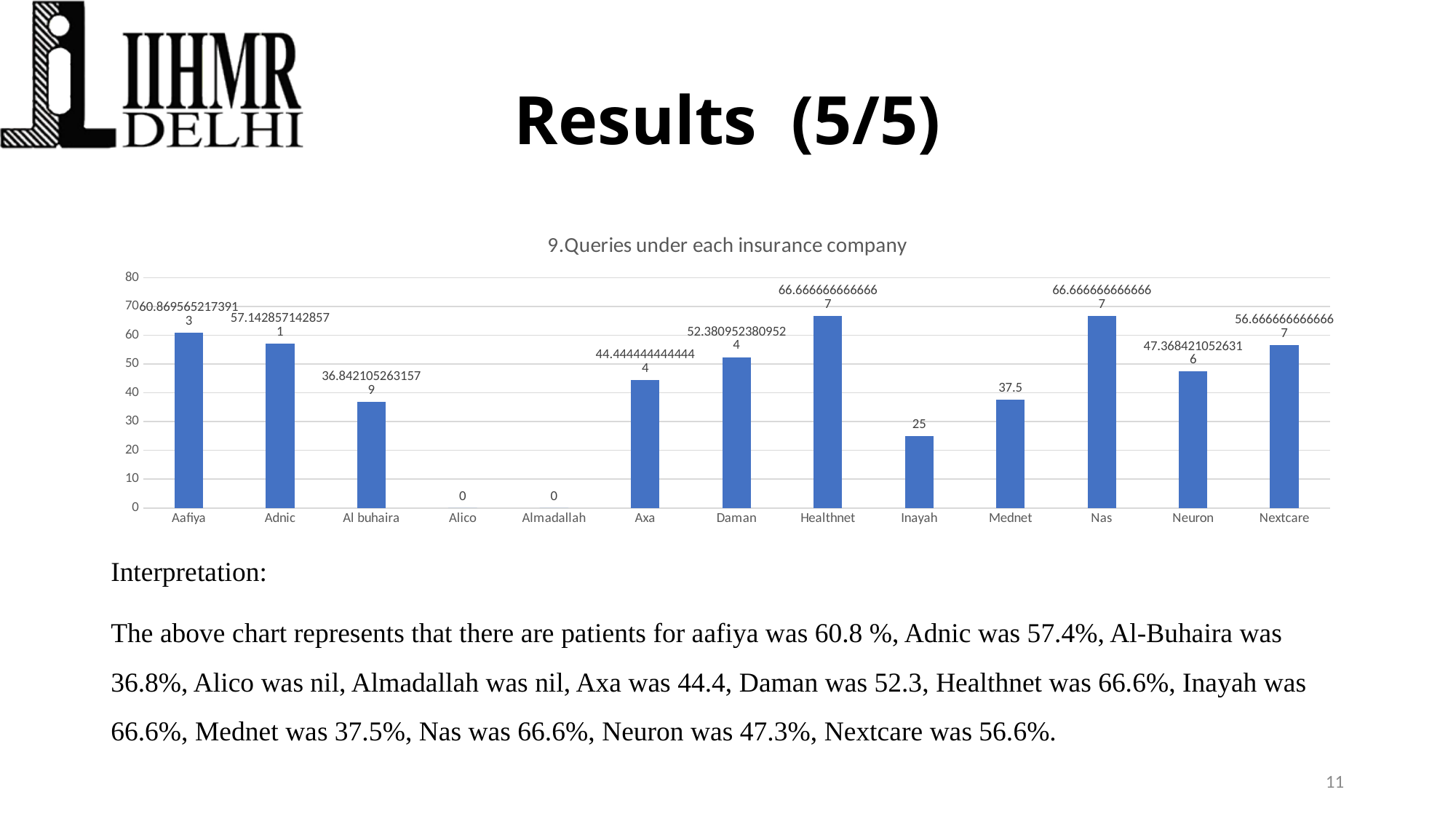
What is the value for Mednet? 37.5 Is the value for Nextcare greater or less than 50? greater What is the value for Healthnet? 66.6666666666667 What is the difference between the values for Mednet and Inayah? 12.5 What is the title of the chart? 9.Queries under each insurance company Which insurance companies have a value of 0? Alico and Almadallah What is the value for Inayah? 25 Which has a larger value, Daman or Axa? Daman What type of chart is shown on the slide? Bar chart What is the value for Alico? 0 How many insurance companies are shown on the x axis of the chart? 13 Which has a larger value, Aafiya or Adnic? Aafiya